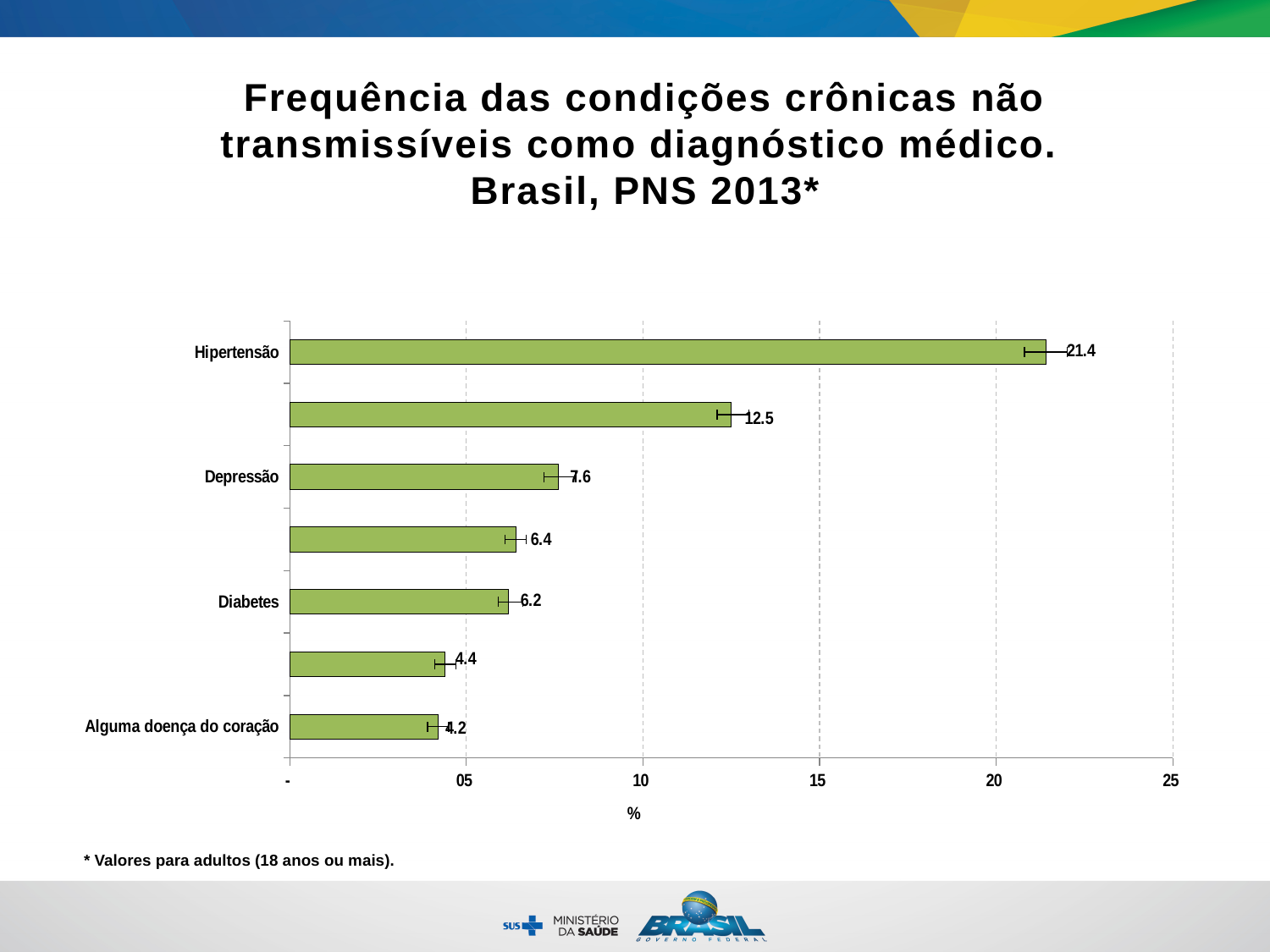
Which condition has the highest value? Hipertensão Which is larger, the value for Depressão or the value for Diabetes? Depressão How many bars are plotted in the chart? 7 Is the value for Hipertensão greater or less than 20? greater Which condition has the lowest value? Alguma doença do coração What is the value for Hipertensão? 21.4 What is the value for Depressão? 7.6 What kind of chart is shown on the slide? Bar chart What is the difference between the values for Hipertensão and Depressão? 13.8 What is the difference between the values for Diabetes and Alguma doença do coração? 2.0 What is the value for Alguma doença do coração? 4.2 What is the value for Diabetes? 6.2